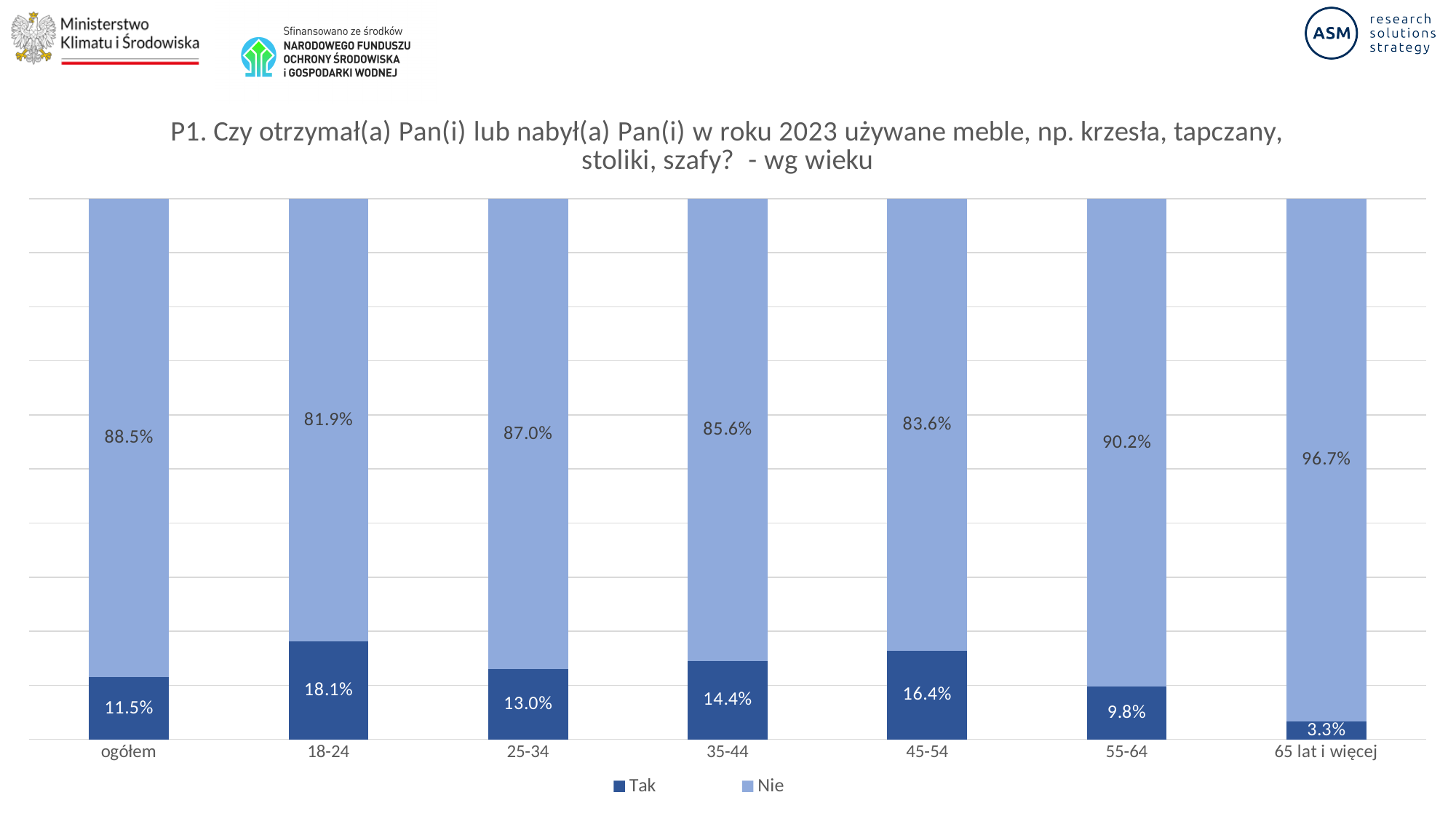
Which category has the highest 'Tak' value? 18-24 What is the 'Nie' value for the 65 lat i więcej age group? 96.7% What is the difference between the 'Tak' values for 18-24 and 55-64? 8.3% What kind of chart is shown on the slide? stacked bar chart What is the 'Tak' value for ogółem? 11.5% How many series does the legend list? 2 What is the 'Tak' value for the 18-24 age group? 18.1% Which category has the lowest 'Tak' value? 65 lat i więcej What is the total of the stacked bar for the 55-64 age group? 100.0% How many categories are shown on the x axis? 7 Which is larger, the 'Tak' value for 35-44 or for 25-34? 35-44 What is the 'Nie' value for the 45-54 age group? 83.6%